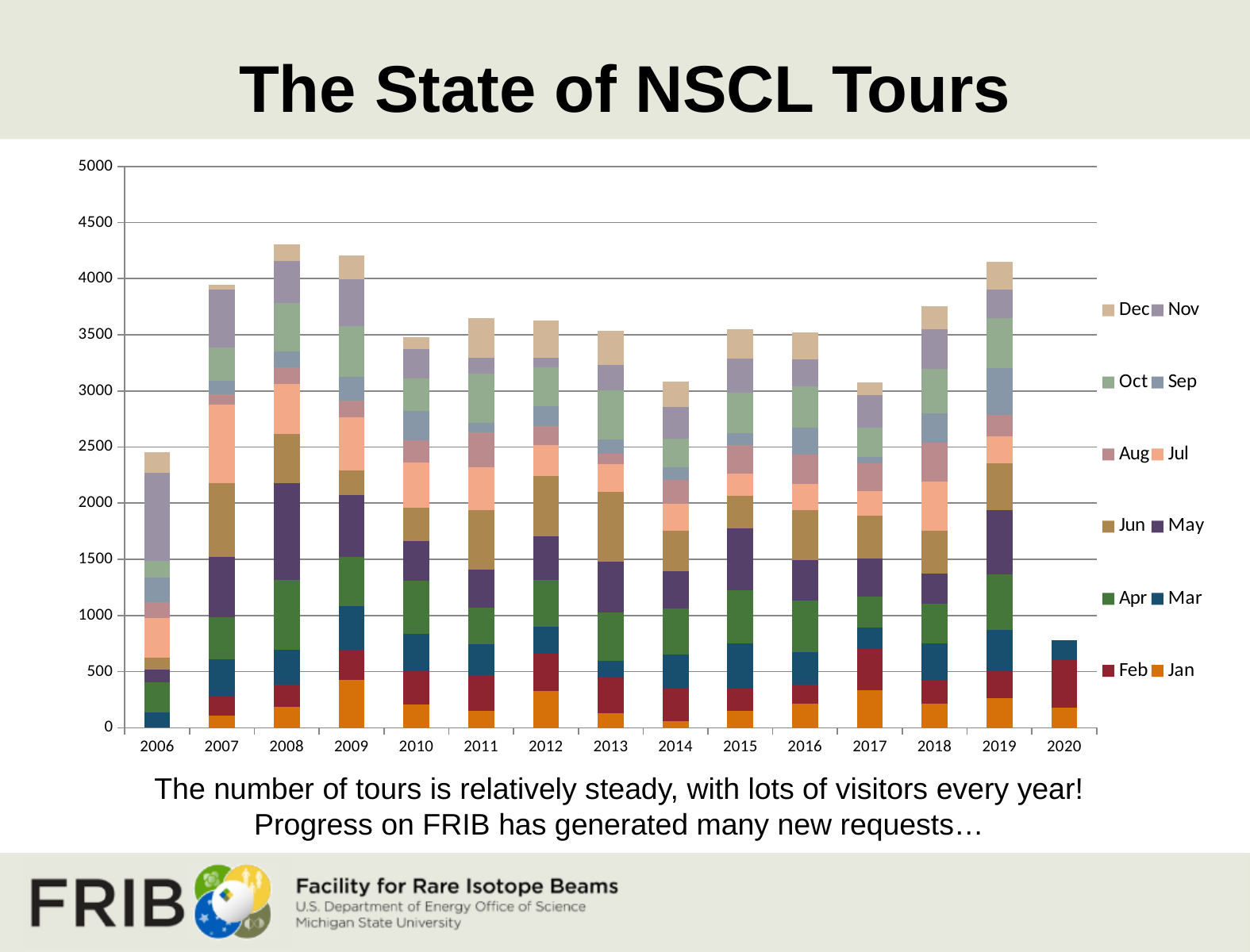
What kind of chart is shown on the slide? Stacked bar chart Is the total for 2018 greater or less than 3500? greater Is the total for 2019 greater or less than 4000? greater How many series does the chart's legend list? 12 How many years are shown along the x axis of the chart? 15 Is the total for 2006 greater or less than 2000? greater Which year has the larger total bar, 2006 or 2007? 2007 Do the total bar heights rise or fall from 2006 to 2008? rise Which year has the lowest total bar in the chart? 2020 What is the title of the slide containing the chart? The State of NSCL Tours